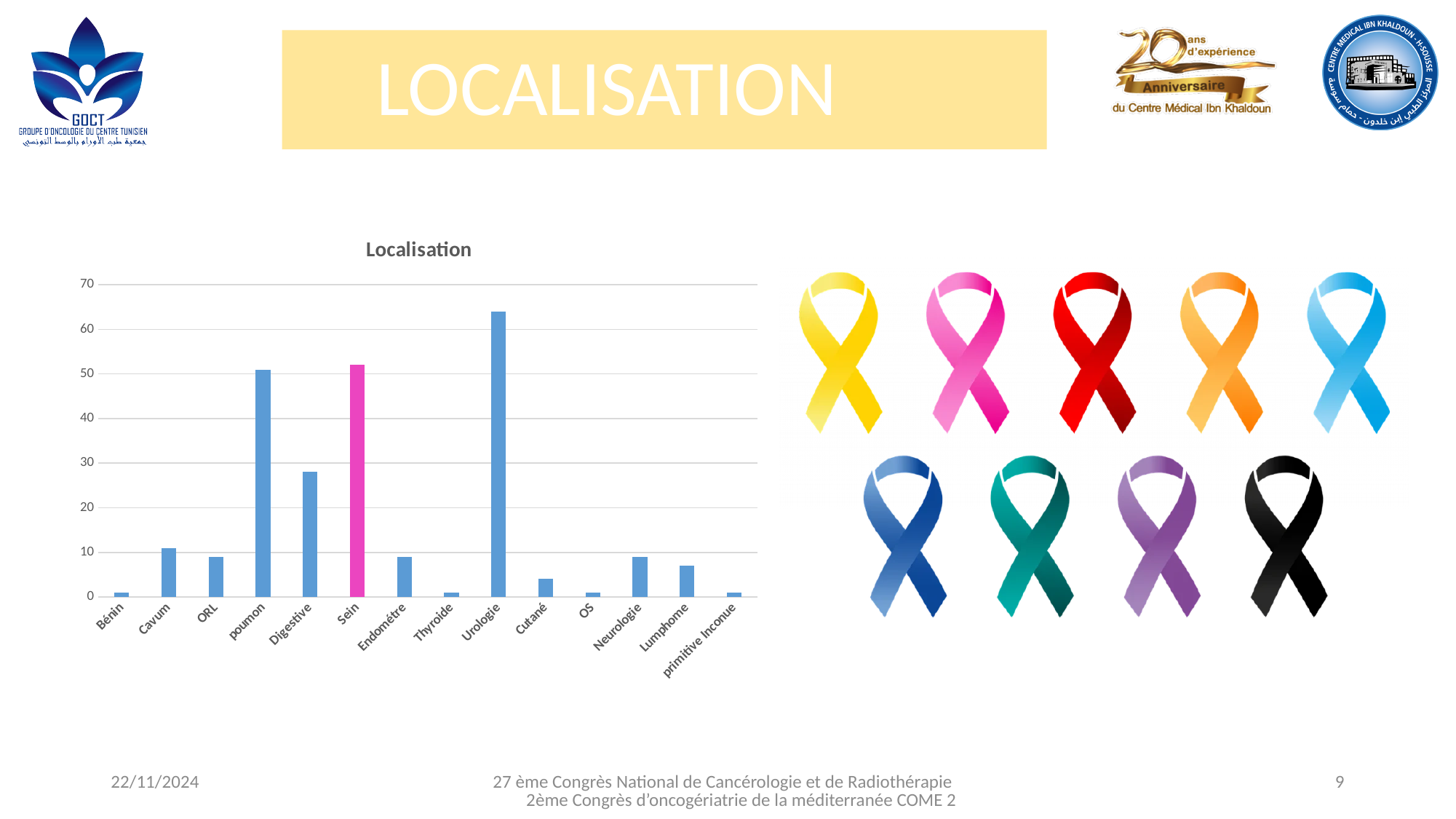
Which has a larger value, poumon or Digestive? poumon What kind of chart is shown on the slide? bar chart Is the value for poumon greater or less than 40? greater Is the value for Urologie greater or less than 60? greater Is the value for Cavum greater or less than 20? less How many categories are shown on the x axis of the chart? 14 Which has a larger value, Urologie or Sein? Urologie What is the title of the chart? Localisation Which category has the highest value in the chart? Urologie